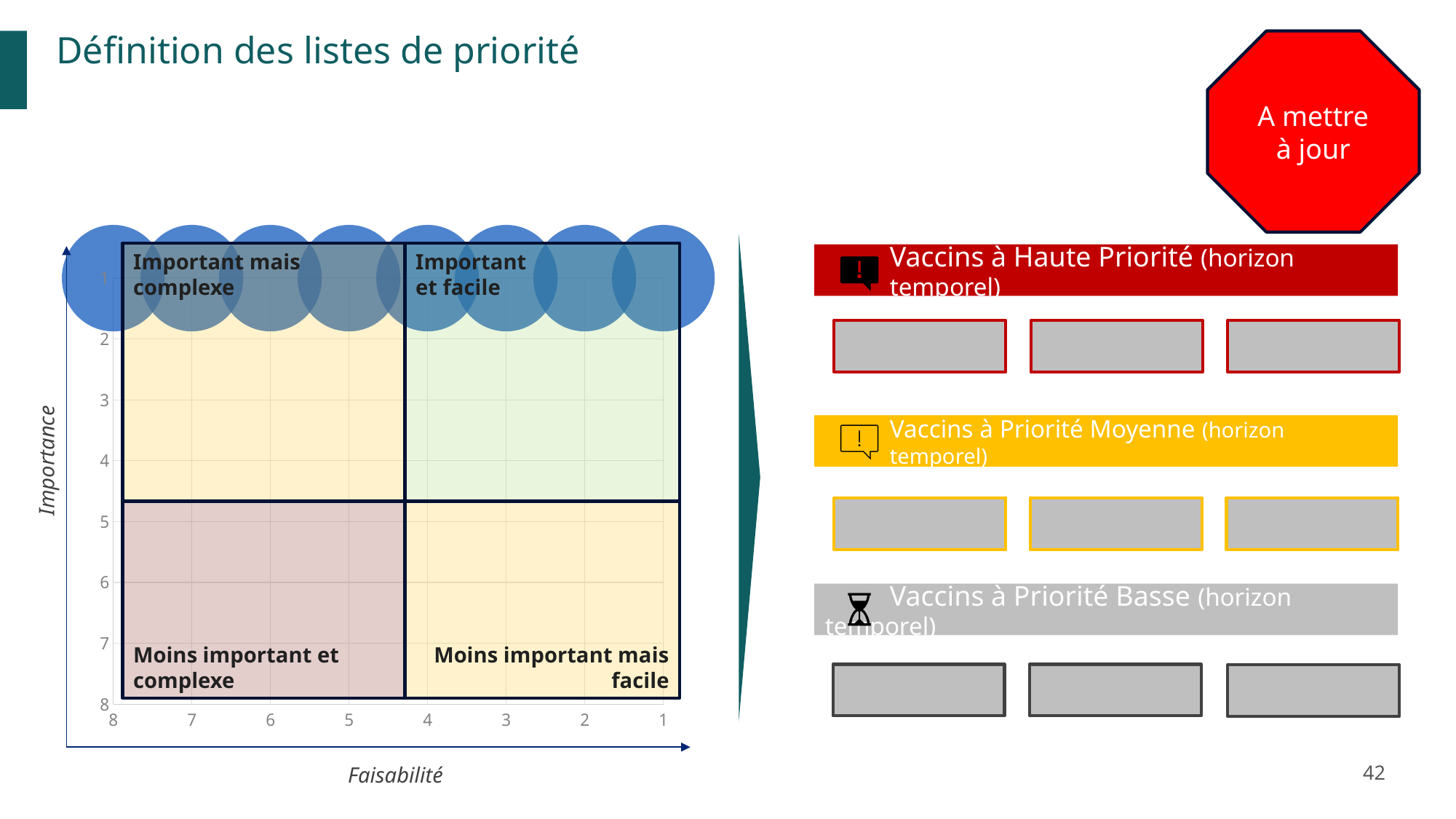
What is the label of the bottom-left quadrant of the chart? Moins important et complexe What is the label of the top-right quadrant of the chart? Important et facile What is the label of the horizontal axis of the chart? Faisabilité What is the label of the vertical axis of the chart? Importance What is the label of the top-left quadrant of the chart? Important mais complexe How many quadrants does the chart divide the plot area into? 4 What is the label of the bottom-right quadrant of the chart? Moins important mais facile How many blue circles are placed along the top of the chart? 8